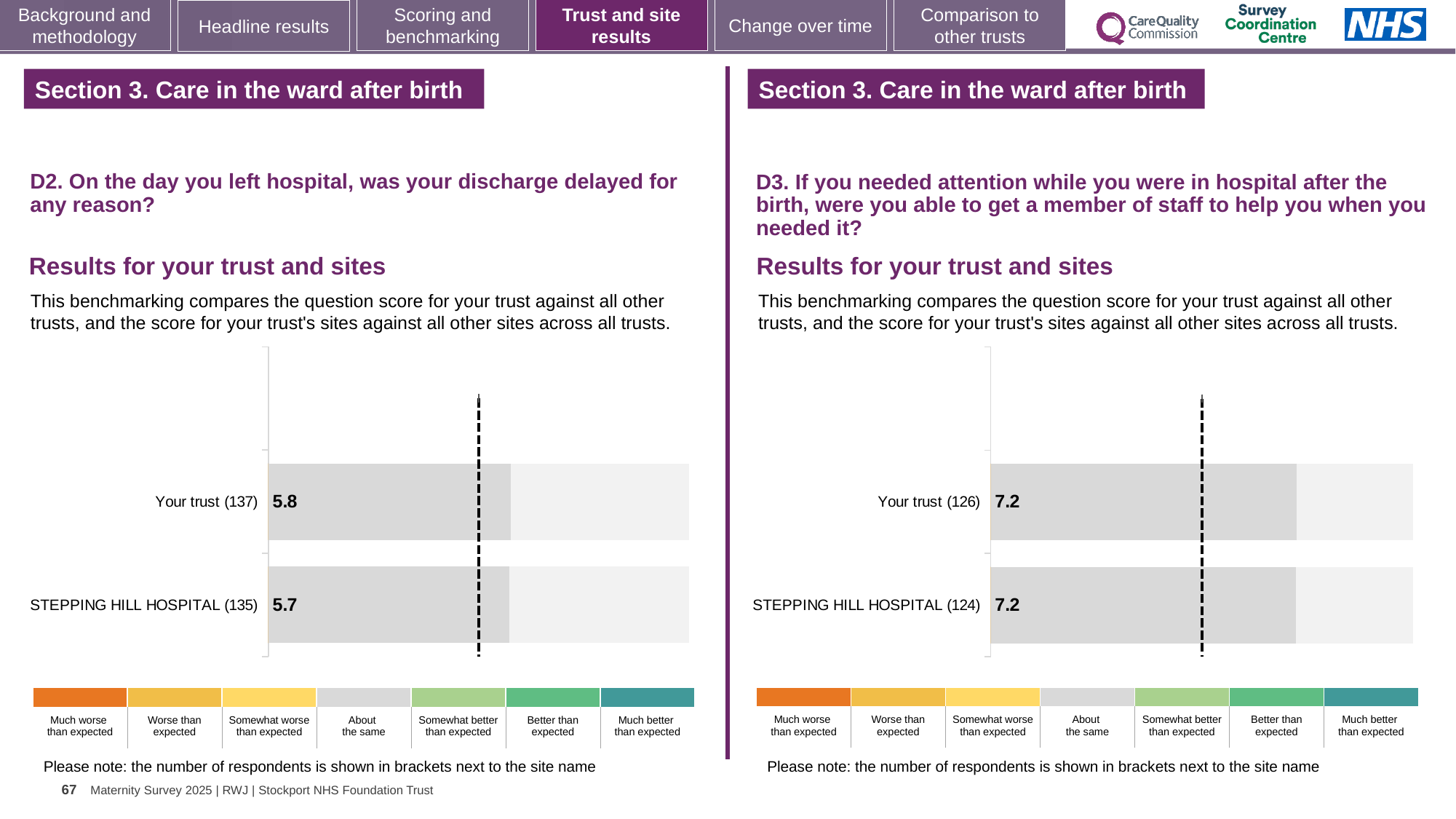
In the D2 chart on the left, what is the difference between the score for Your trust and the score for STEPPING HILL HOSPITAL? 0.1 In the D2 chart on the left, what is the score for STEPPING HILL HOSPITAL? 5.7 How many bars are plotted in the D2 chart on the left? 2 In the D3 chart on the right, how many respondents are shown in brackets for STEPPING HILL HOSPITAL? 124 In the D3 chart on the right, what is the score for STEPPING HILL HOSPITAL? 7.2 How many categories does the colour key below the D2 chart on the left list? 7 What type of chart is used for the D3 results on the right? Bar chart In the D2 chart on the left, which has the higher score, Your trust or STEPPING HILL HOSPITAL? Your trust In the D2 chart on the left, what is the score for Your trust? 5.8 In the D3 chart on the right, what is the score for Your trust? 7.2 In the D2 chart on the left, how many respondents are shown in brackets for Your trust? 137 In the D3 chart on the right, what is the difference between the score for Your trust and the score for STEPPING HILL HOSPITAL? 0